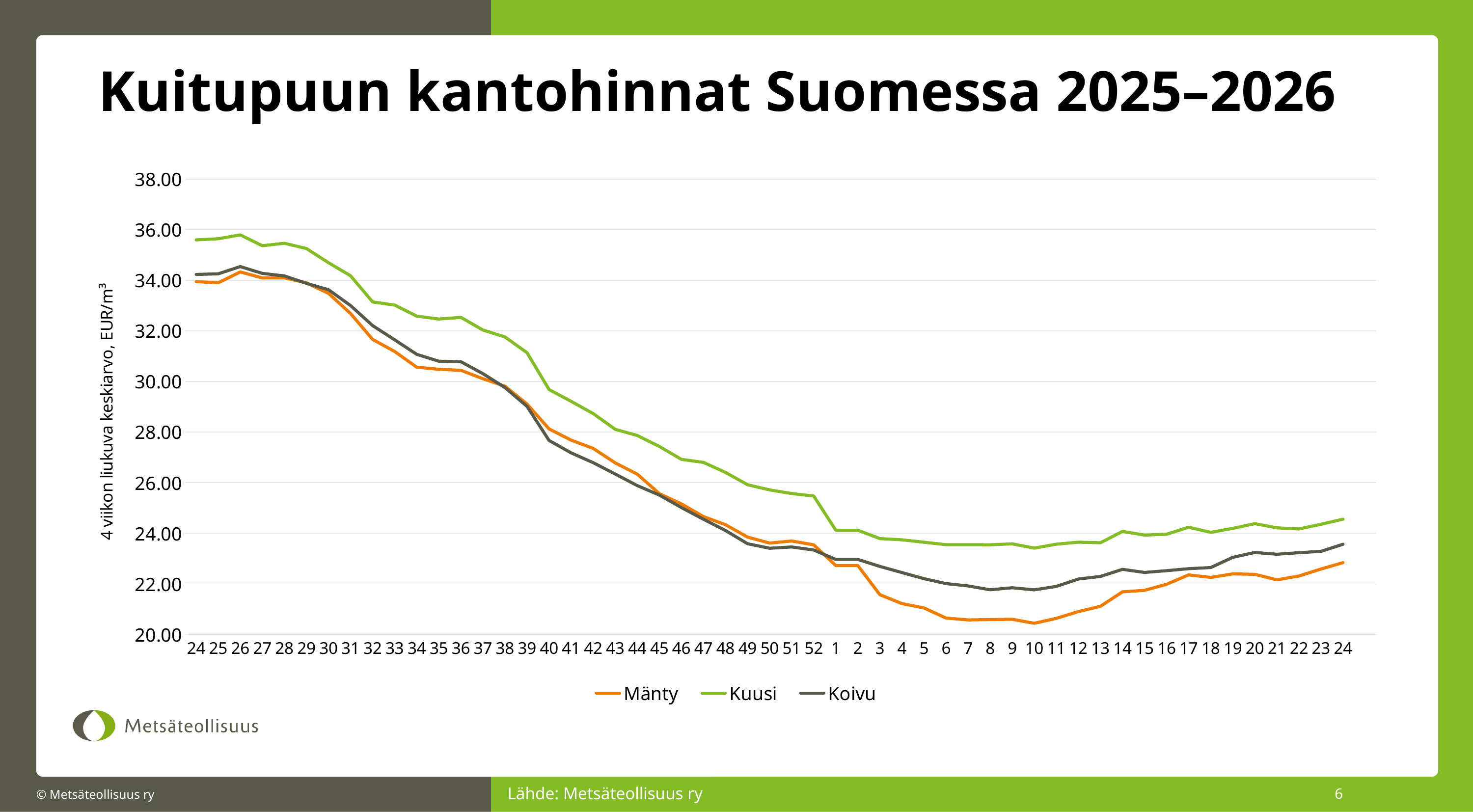
How many series does the legend list? 3 Is the value for Mänty at week 10 greater or less than 22.00? less At the last week shown (week 24), which is higher, Koivu or Mänty? Koivu Is the value for Koivu at week 40 greater or less than 30.00? less Which series has the highest value at week 40? Kuusi How many week points are shown along the x axis? 53 What kind of chart is shown on the slide? line chart Is the value for Kuusi at week 26 greater or less than 34.00? greater Does the Mänty line rise or fall from week 24 to week 10? fall What is the title of the chart? Kuitupuun kantohinnat Suomessa 2025–2026 What unit is shown on the y-axis label? EUR/m³ Which series has the lowest value at week 10? Mänty